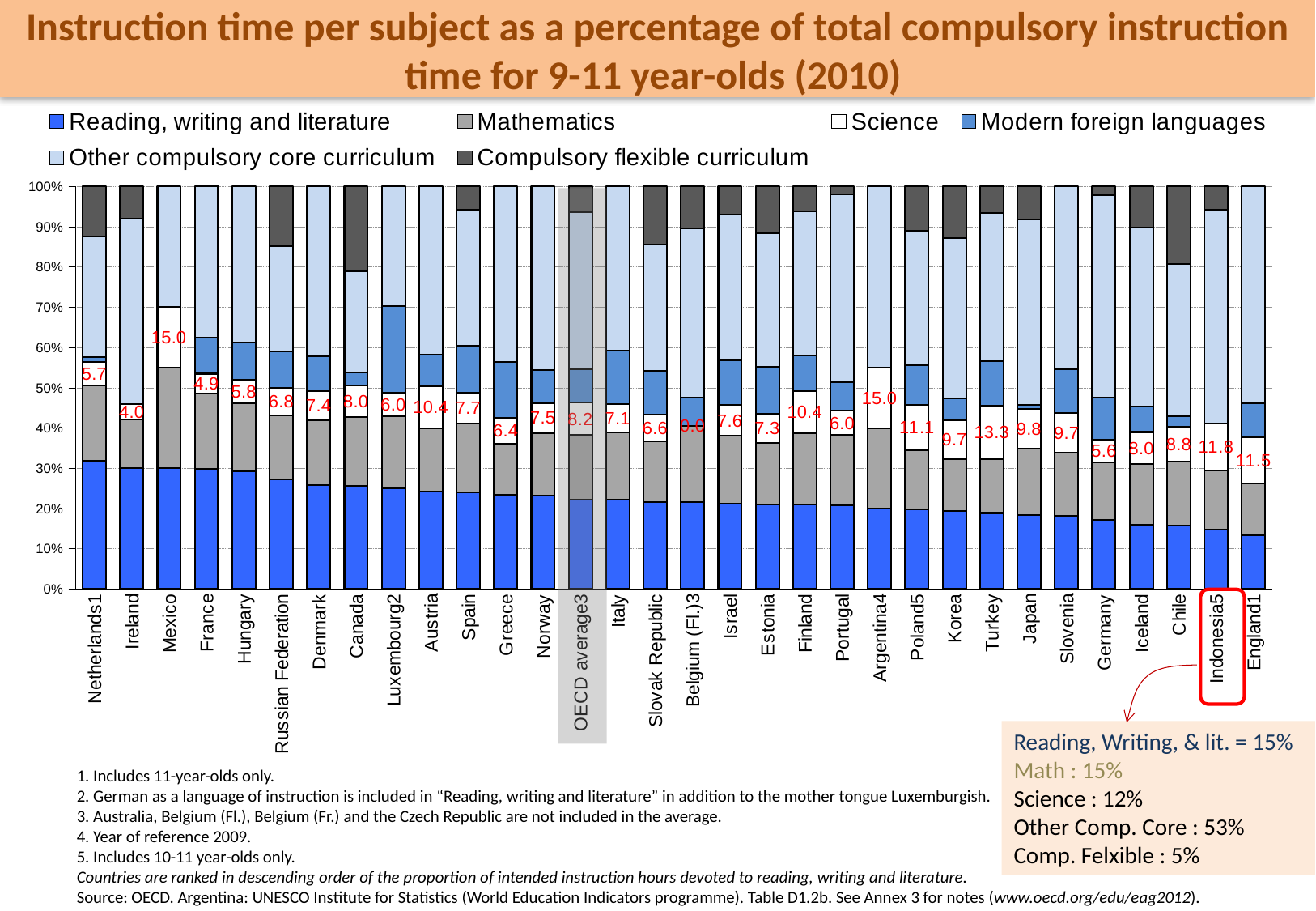
What is the Science data label for the OECD average? 8.2 Does the Reading, writing and literature share rise or fall from left to right across the countries? Fall How many series does the legend list? 6 Which country has the lowest Science data label? Belgium (Fl.)3 What kind of chart is shown on the slide? Stacked bar chart What is the Science data label for Turkey? 13.3 According to the callout box, what is the Other Comp. Core share for Indonesia? 53% Is the Reading, writing and literature share for Netherlands greater or less than 20%? greater Which has a larger Science label, Austria or Greece? Austria What is the difference between the Science labels for Indonesia (11.8) and England (11.5)? 0.3 What is the Science data label for Mexico? 15.0 How many countries/entities are shown along the x axis? 32